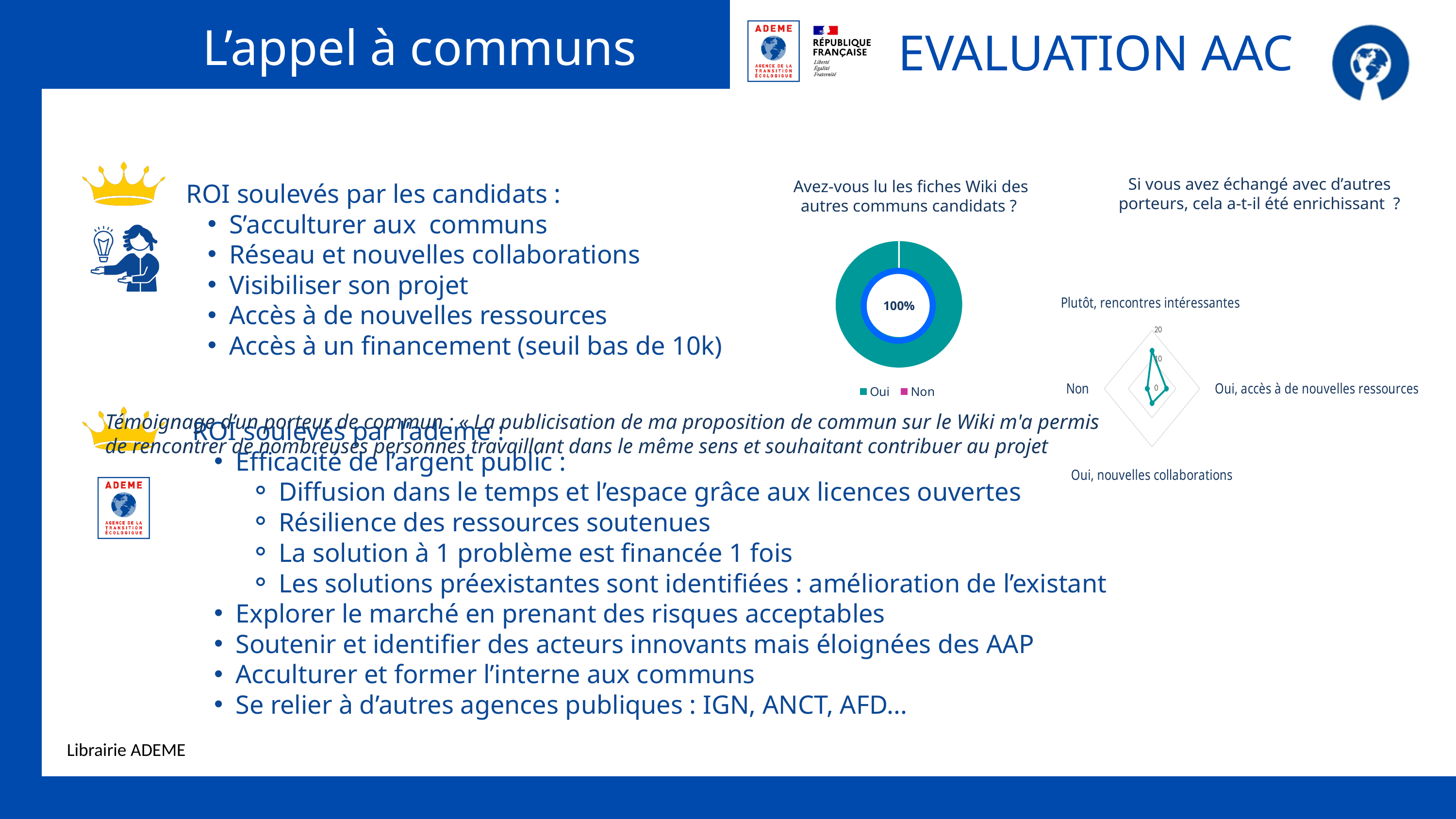
What kind of chart is the one titled 'Si vous avez échangé avec d'autres porteurs, cela a-t-il été enrichissant ?'? Radar chart In the radar chart 'Si vous avez échangé avec d'autres porteurs, cela a-t-il été enrichissant ?', which category has the highest value? Plutôt, rencontres intéressantes In the chart titled 'Avez-vous lu les fiches Wiki des autres communs candidats ?', what share of respondents answered 'Oui'? 100% In the radar chart 'Si vous avez échangé avec d'autres porteurs, cela a-t-il été enrichissant ?', is the value for 'Oui, nouvelles collaborations' greater or less than 10? less In the radar chart 'Si vous avez échangé avec d'autres porteurs, cela a-t-il été enrichissant ?', which is larger: the value for 'Plutôt, rencontres intéressantes' or the value for 'Oui, accès à de nouvelles ressources'? Plutôt, rencontres intéressantes How many categories (axes) does the radar chart 'Si vous avez échangé avec d'autres porteurs, cela a-t-il été enrichissant ?' have? 4 In the radar chart 'Si vous avez échangé avec d'autres porteurs, cela a-t-il été enrichissant ?', is the value for 'Non' greater or less than 10? less What is the maximum value shown on the axis of the radar chart 'Si vous avez échangé avec d'autres porteurs, cela a-t-il été enrichissant ?'? 20 In the chart 'Avez-vous lu les fiches Wiki des autres communs candidats ?', which legend entry is shown in teal? Oui How many entries does the legend of the chart 'Avez-vous lu les fiches Wiki des autres communs candidats ?' list? 2 What kind of chart is the one titled 'Avez-vous lu les fiches Wiki des autres communs candidats ?'? Doughnut chart